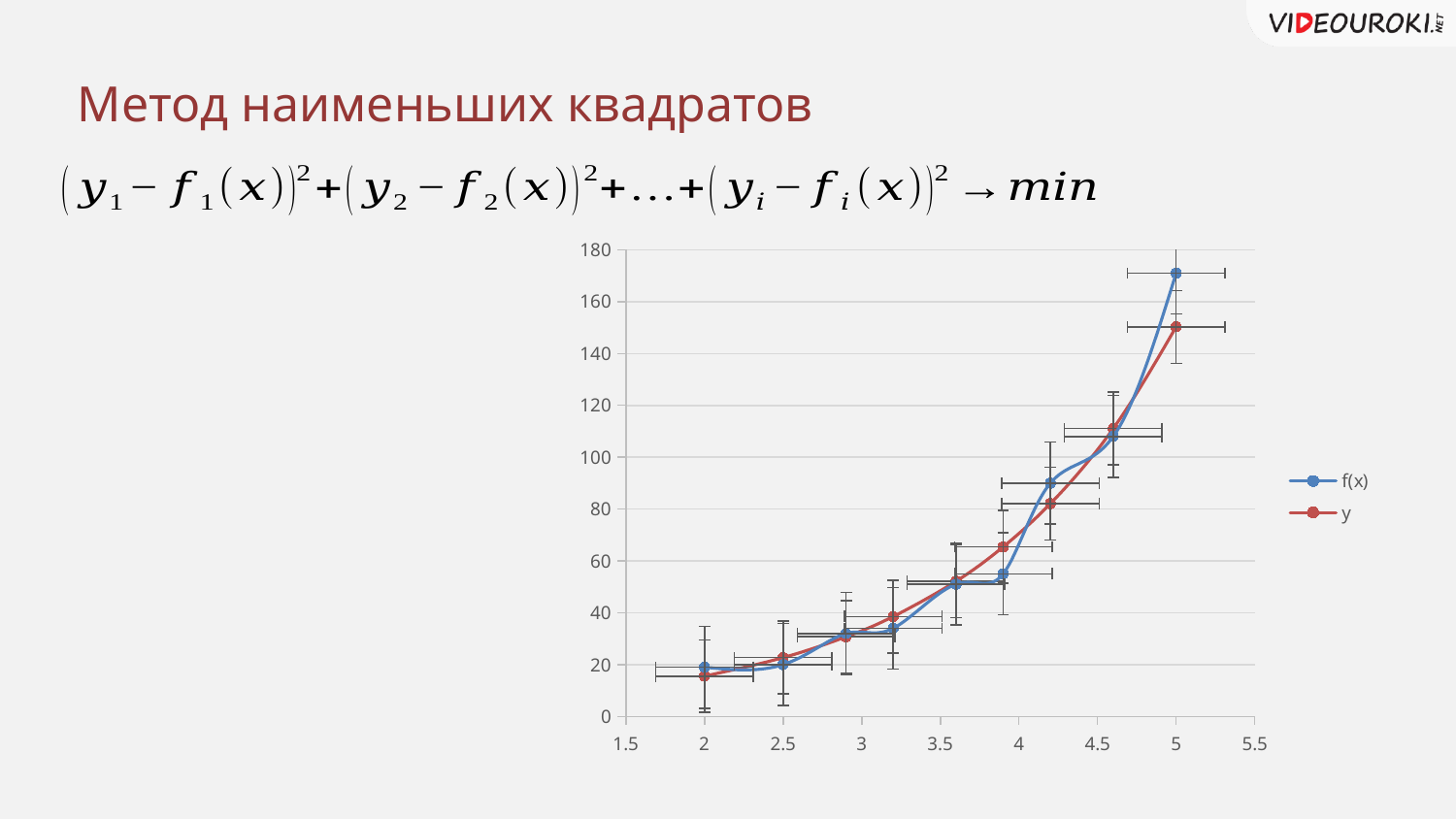
Is the value of f(x) at x = 5 greater or less than 160? greater Is the value of f(x) at x = 3.9 greater or less than 60? less Is the value of y at x = 2 greater or less than 20? less At which x value does the y series have its lowest value? 2 How many series does the chart legend list? 2 What colour is the line for the series y? Red Do the values of the y series generally rise or fall as x increases? Rise How many data points does the f(x) series have? 9 At which x value does the f(x) series reach its highest value? 5 What are the names of the two series in the chart legend? f(x) and y At x = 5, which series has the larger value, f(x) or y? f(x) At x = 3.9, which series has the larger value, f(x) or y? y